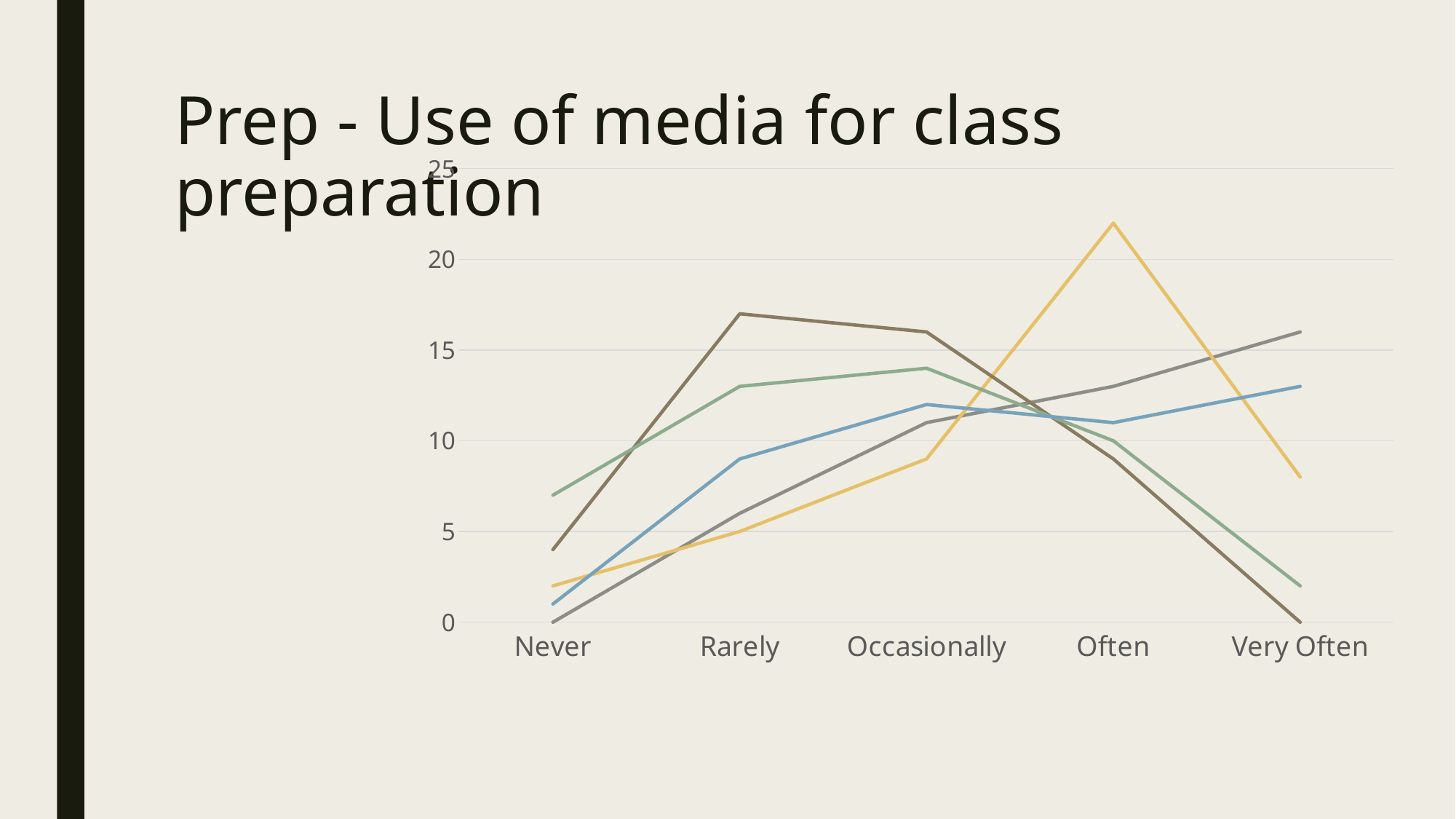
Does the gray line rise or fall from Never to Very Often? rise What is the title of the slide containing the chart? Prep - Use of media for class preparation Is the value of the blue line at Very Often greater or less than 15? less How many lines are plotted on the chart? 5 How many categories are shown on the x axis of the chart? 5 What is the value of the gray line at Never? 0 Is the value of the brown line at Rarely greater or less than 15? greater At which category does the yellow line reach its highest value? Often What kind of chart is shown on the slide? line chart What is the value of the brown line at Very Often? 0 Is the value of the yellow line at Often greater or less than 20? greater